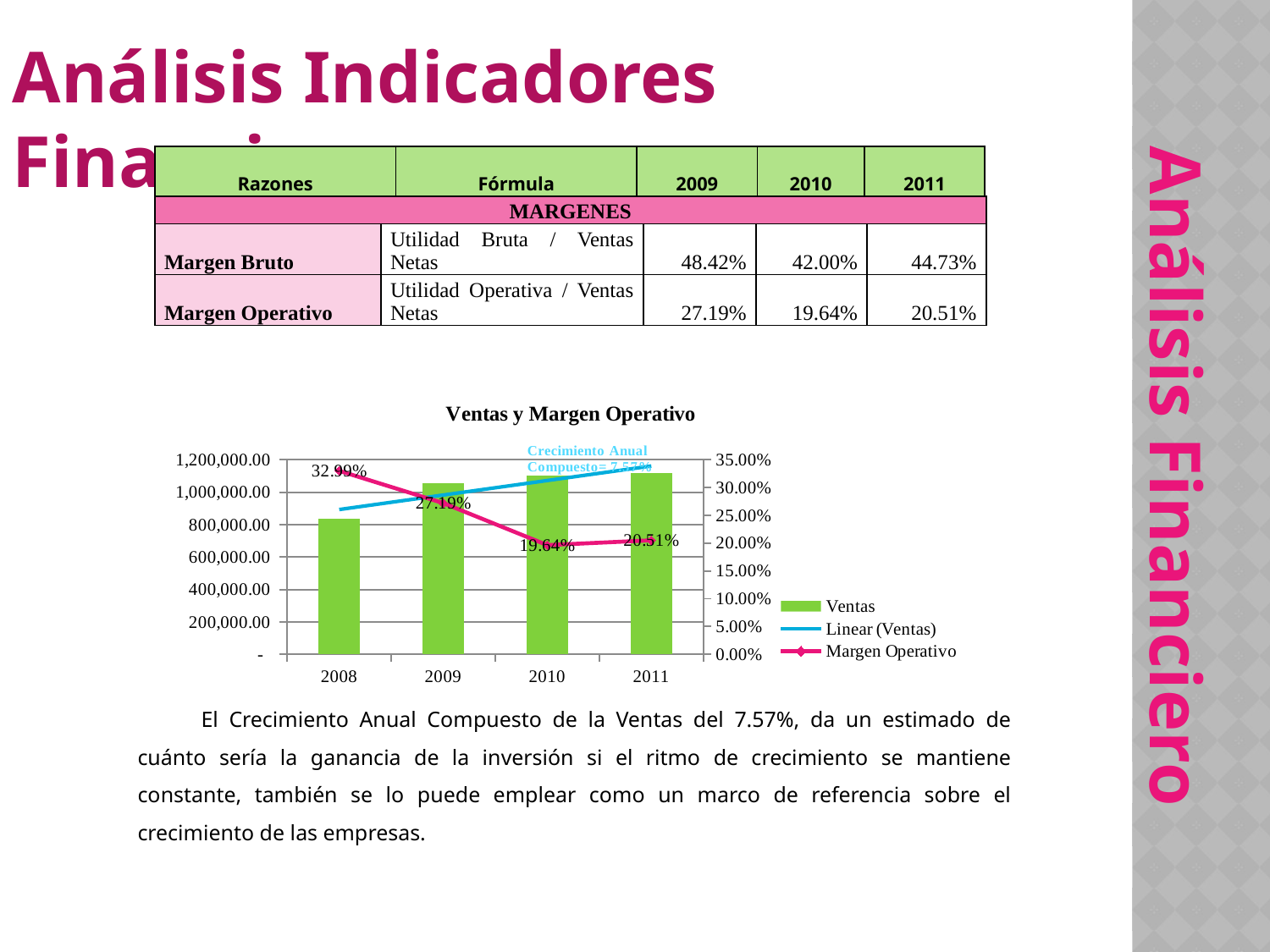
How many entries does the chart legend list? 3 What is the title of the chart on the slide? Ventas y Margen Operativo Is the Ventas value for 2008 greater or less than 1,000,000.00? less What is the Margen Operativo value for 2008 in the chart? 32.99% By how many percentage points did the Margen Operativo fall from 2008 to 2009? 5.80 percentage points How many years are shown on the x axis of the chart? 4 Is the Ventas value for 2011 greater or less than 1,000,000.00? greater What is the Margen Operativo value for 2010 in the chart? 19.64% Which year has the larger Margen Operativo, 2009 or 2011? 2009 What is the Margen Operativo value for 2011 in the chart? 20.51% In which year is the Margen Operativo highest in the chart? 2008 In which year is the Margen Operativo lowest in the chart? 2010